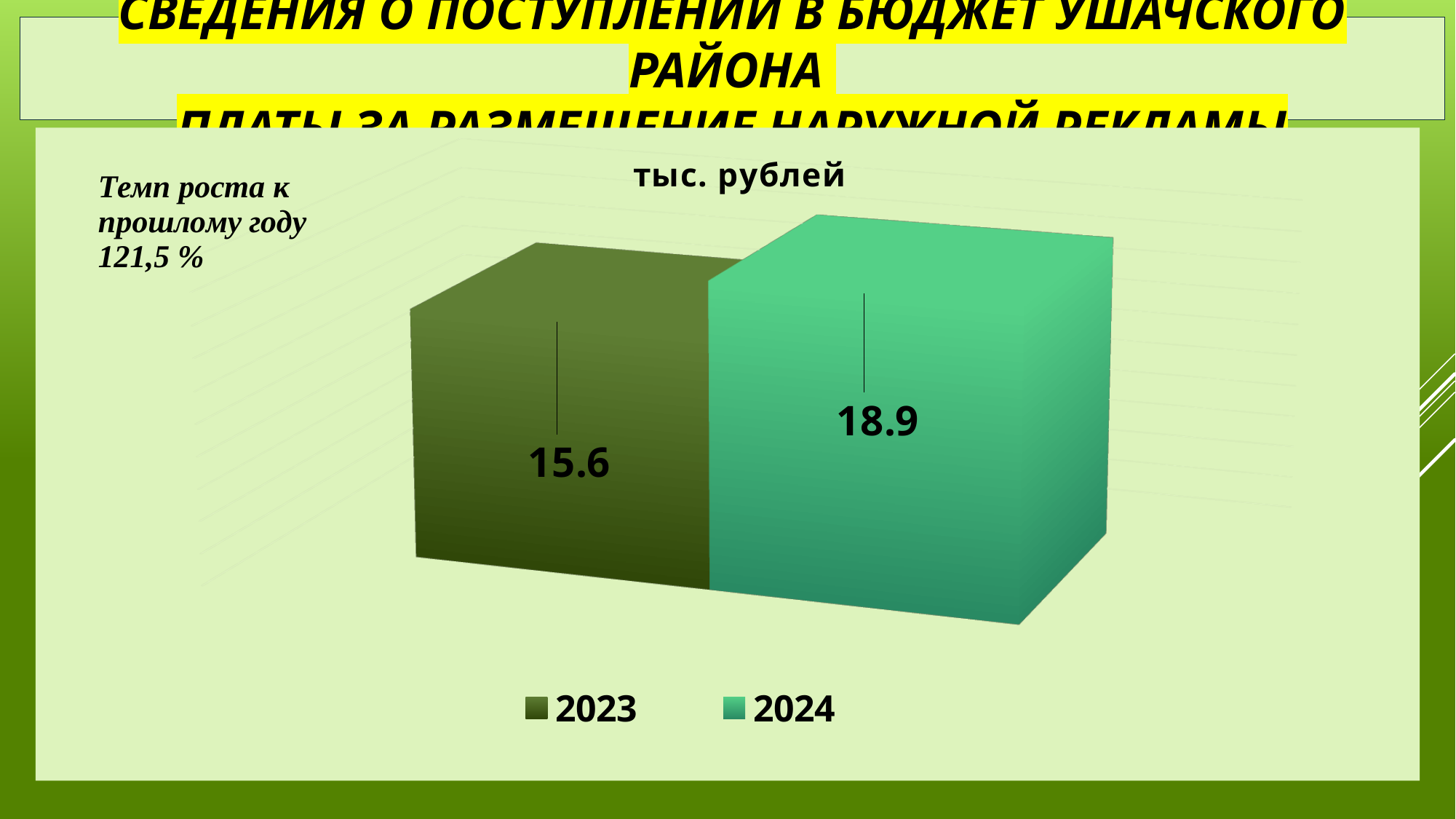
Which year has the higher value? 2024 Is the value for 2024 larger than the value for 2023? Yes Which year has the lower value? 2023 What kind of chart is shown? Bar chart What is the difference between the 2024 and 2023 values? 3.3 Do the values rise or fall from 2023 to 2024? Rise What is the value for 2024? 18.9 What is the chart's title? тыс. рублей What is the value for 2023? 15.6 What growth rate to the previous year is stated on the slide? 121,5 % How many series does the legend list? 2